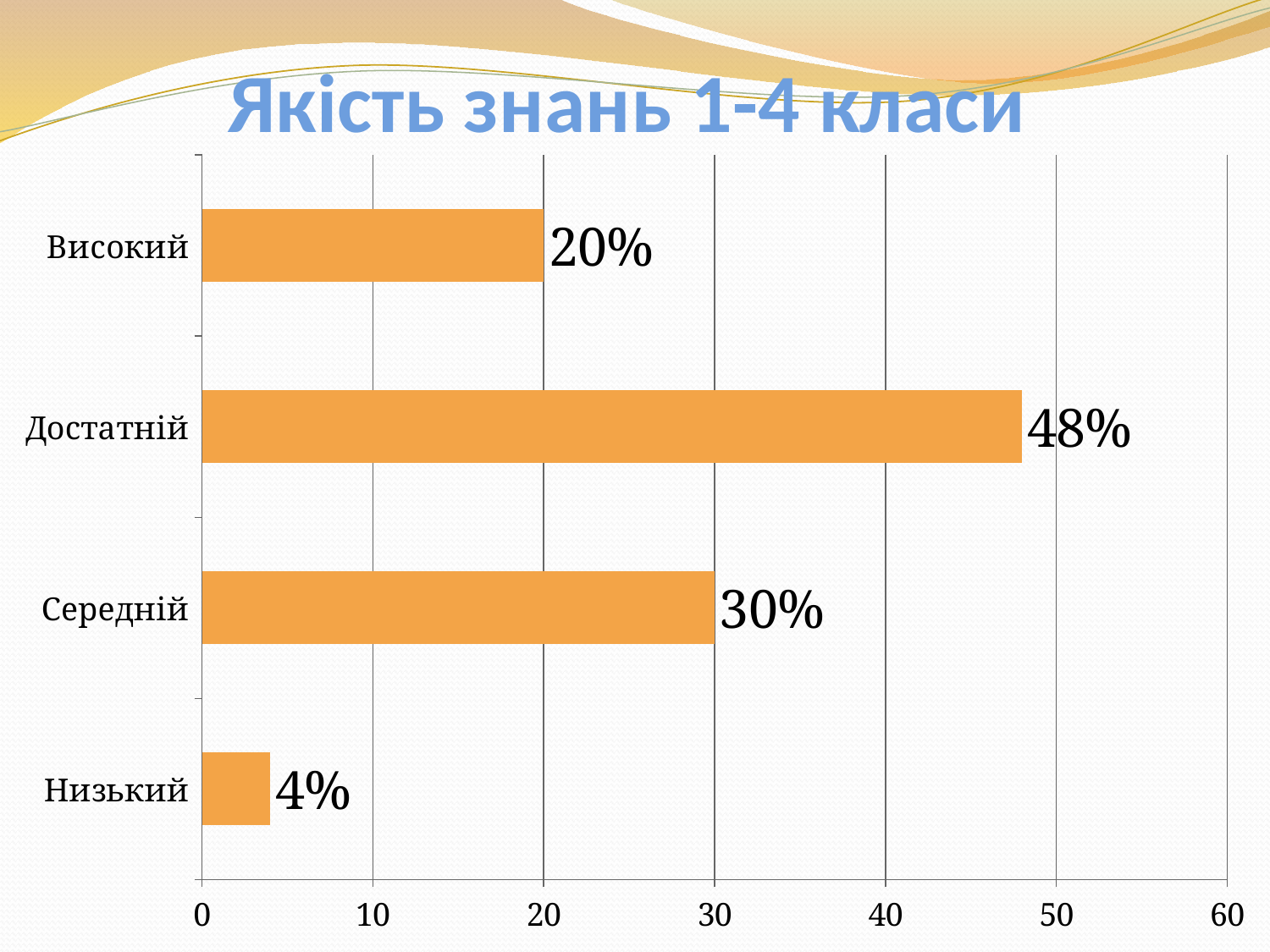
What is the title of the chart? Якість знань 1-4 класи What is the value for Достатній? 48% What is the difference between the values for Достатній and Середній? 18% Which category has the lowest value? Низький What is the value for Високий? 20% Which category has the highest value? Достатній What kind of chart is shown on the slide? Bar chart How many categories are shown in the chart? 4 What is the value for Середній? 30% What is the value for Низький? 4% What is the difference between the values for Високий and Низький? 16% Which is larger, the value for Середній or the value for Високий? Середній